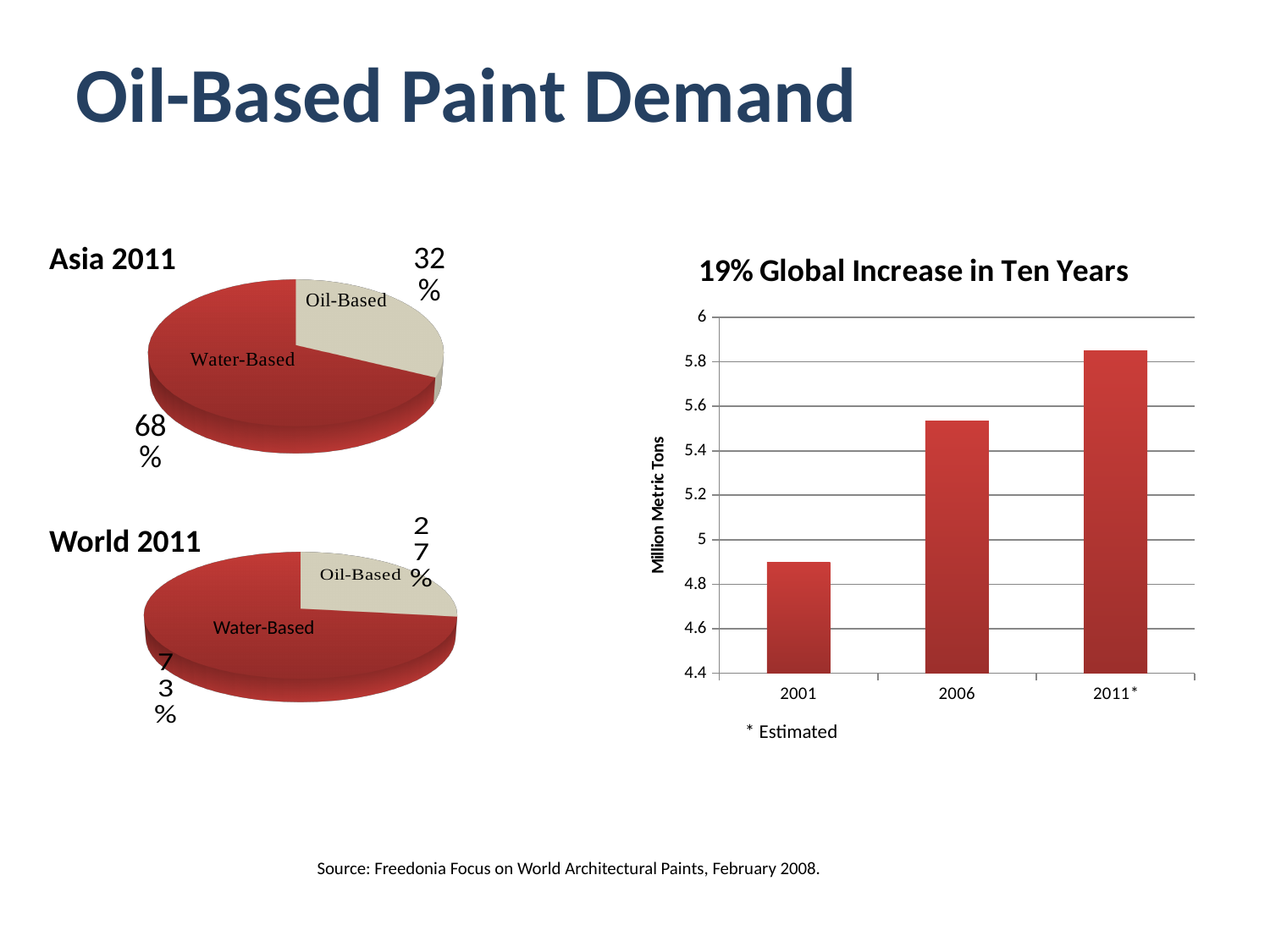
How many percentage points higher is the Oil-Based share in the Asia 2011 pie chart than in the World 2011 pie chart? 5 In the World 2011 pie chart, what share is Water-Based? 73% In the '19% Global Increase in Ten Years' chart, is the value for 2006 greater or less than 5.4? greater In the World 2011 pie chart, which slice is larger, Oil-Based or Water-Based? Water-Based In the '19% Global Increase in Ten Years' chart, which year has the highest bar? 2011* In the '19% Global Increase in Ten Years' chart, do the values rise or fall from 2001 to 2011*? rise In the Asia 2011 pie chart, what share is Water-Based? 68% In the World 2011 pie chart, what share is Oil-Based? 27% In the Asia 2011 pie chart, what share is Oil-Based? 32% What is the y-axis label of the '19% Global Increase in Ten Years' chart? Million Metric Tons In the '19% Global Increase in Ten Years' chart, is the value for 2001 greater or less than 5? less In the '19% Global Increase in Ten Years' chart, which year has the lowest bar? 2001